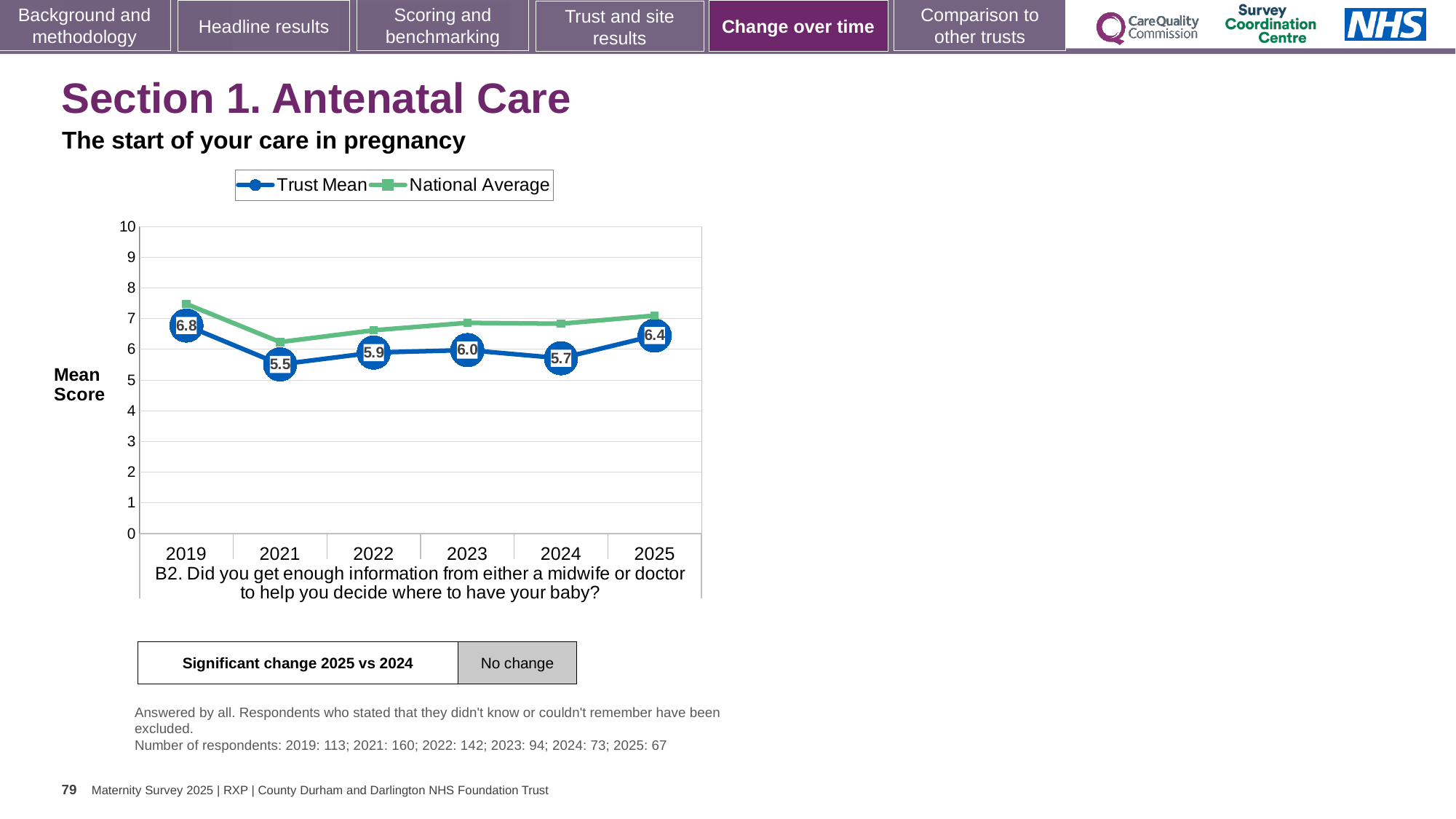
What is the Trust Mean score for 2025? 6.4 What kind of chart is shown? line chart In which year is the Trust Mean lowest? 2021 Does the Trust Mean rise or fall from 2024 to 2025? rise How many years are shown on the x axis? 6 Is the National Average for 2019 greater or less than 7? greater What is the Trust Mean score for 2019? 6.8 What is the Trust Mean score for 2021? 5.5 Which is larger, the Trust Mean in 2023 or in 2024? 2023 How many series does the legend list? 2 In which year is the Trust Mean highest? 2019 What is the difference between the Trust Mean in 2019 and in 2021? 1.3